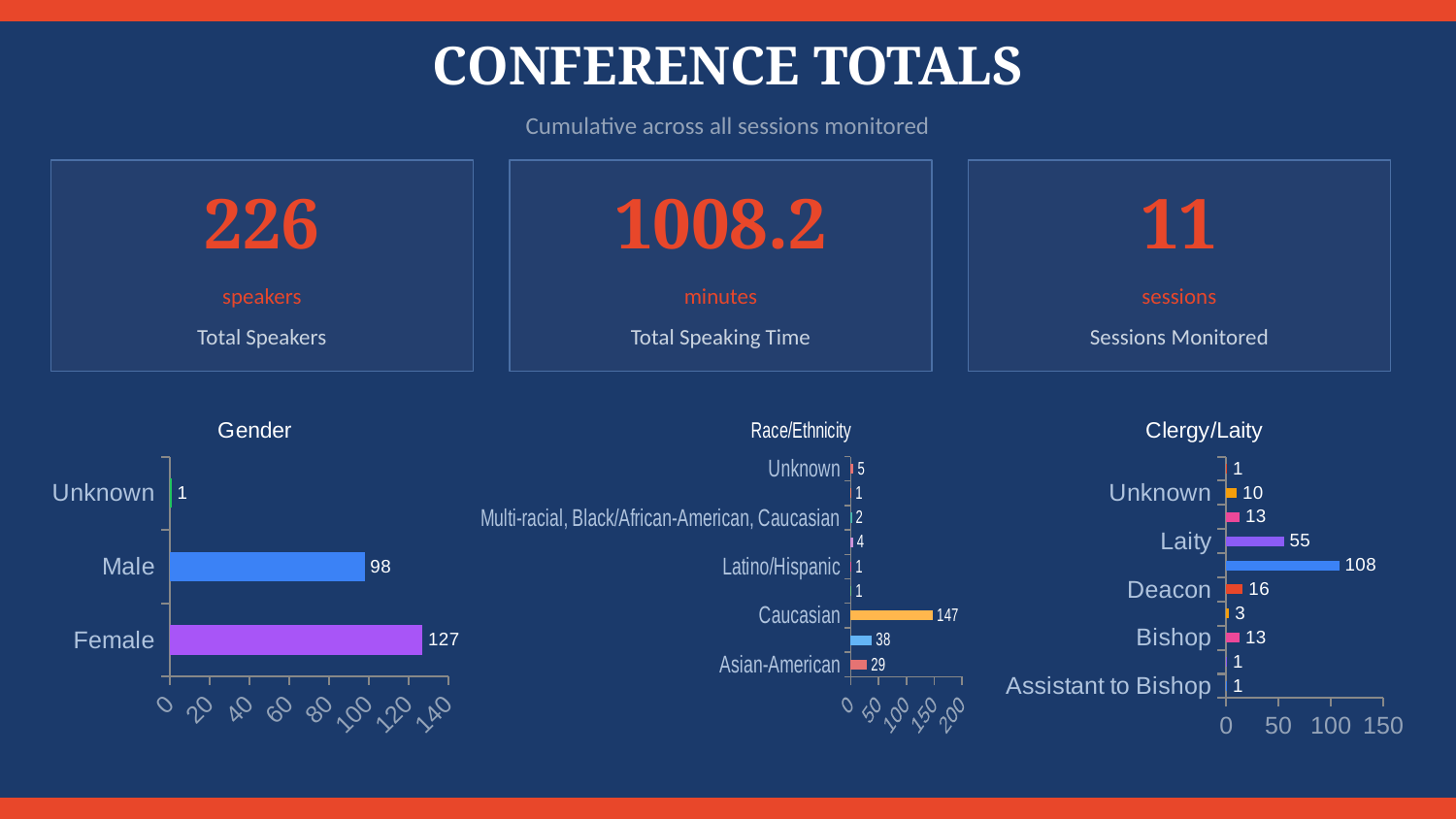
In the Gender chart, what is the difference between the Female and Male values? 29 In the Gender chart, how many categories are shown? 3 In the Race/Ethnicity chart, which category has the highest value? Caucasian In the Race/Ethnicity chart, what is the value for Unknown? 5 In the Race/Ethnicity chart, what is the value for Asian-American? 29 What type of chart is the Gender chart? Bar chart In the Gender chart, what is the value for Male? 98 In the Gender chart, which category has the lowest value? Unknown In the Gender chart, what is the value for Female? 127 In the Gender chart, which category has the highest value? Female In the Clergy/Laity chart, what is the largest value shown on any bar? 108 In the Race/Ethnicity chart, what is the value for Caucasian? 147